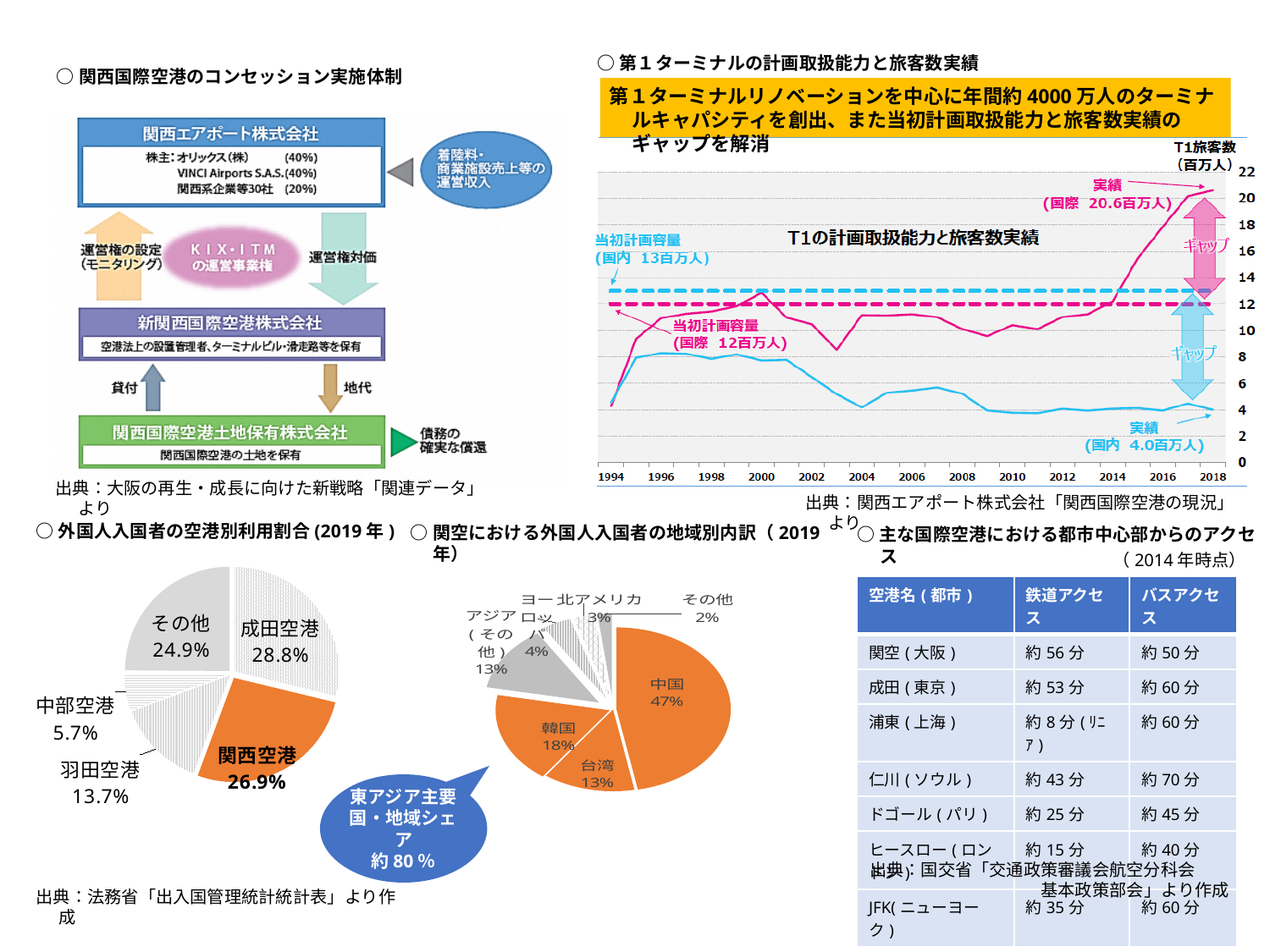
What kind of chart is the chart titled T1の計画取扱能力と旅客数実績? Line chart In the pie chart 関空における外国人入国者の地域別内訳(2019年), which region has the largest share? 中国 In the pie chart 外国人入国者の空港別利用割合(2019年), what share is shown for 成田空港? 28.8% In the pie chart 外国人入国者の空港別利用割合(2019年), how many percentage points larger is 成田空港's share than 関西空港's? 1.9 In the pie chart 外国人入国者の空港別利用割合(2019年), what share is shown for 関西空港? 26.9% How many slices does the pie chart 外国人入国者の空港別利用割合(2019年) have? 5 How many slices does the pie chart 関空における外国人入国者の地域別内訳(2019年) have? 7 In the chart T1の計画取扱能力と旅客数実績, what is the labelled 実績 value for 国際 at the end of the series? 20.6百万人 In the pie chart 関空における外国人入国者の地域別内訳(2019年), what share is shown for 中国? 47% In the pie chart 外国人入国者の空港別利用割合(2019年), which airport has the largest share? 成田空港 In the pie chart 外国人入国者の空港別利用割合(2019年), which airport has the smallest share? 中部空港 In the pie chart 関空における外国人入国者の地域別内訳(2019年), which is larger, the share for 韓国 or for 台湾? 韓国